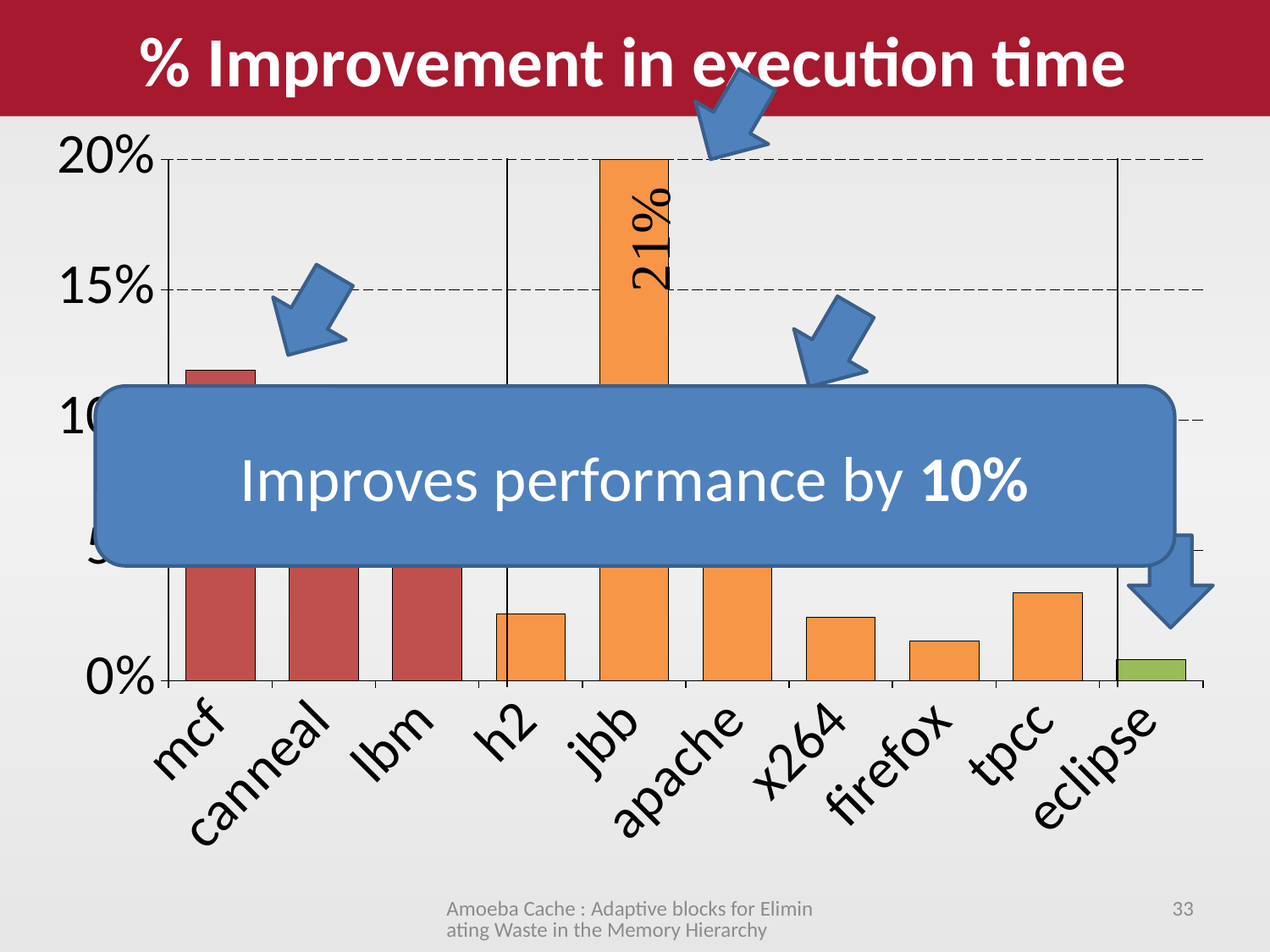
Which category has the highest % improvement in execution time? jbb Which category has the lowest % improvement in execution time? eclipse What is the title of the chart on the slide? % Improvement in execution time Is the value for eclipse greater or less than 5%? less What is the % improvement in execution time for jbb? 21% Which has a larger % improvement in execution time, mcf or h2? mcf Is the value for mcf greater or less than 10%? greater How many categories are shown on the x axis of the chart? 10 What kind of chart is shown on the slide? bar chart Is the value for tpcc greater or less than 5%? less Which has a larger % improvement in execution time, tpcc or firefox? tpcc